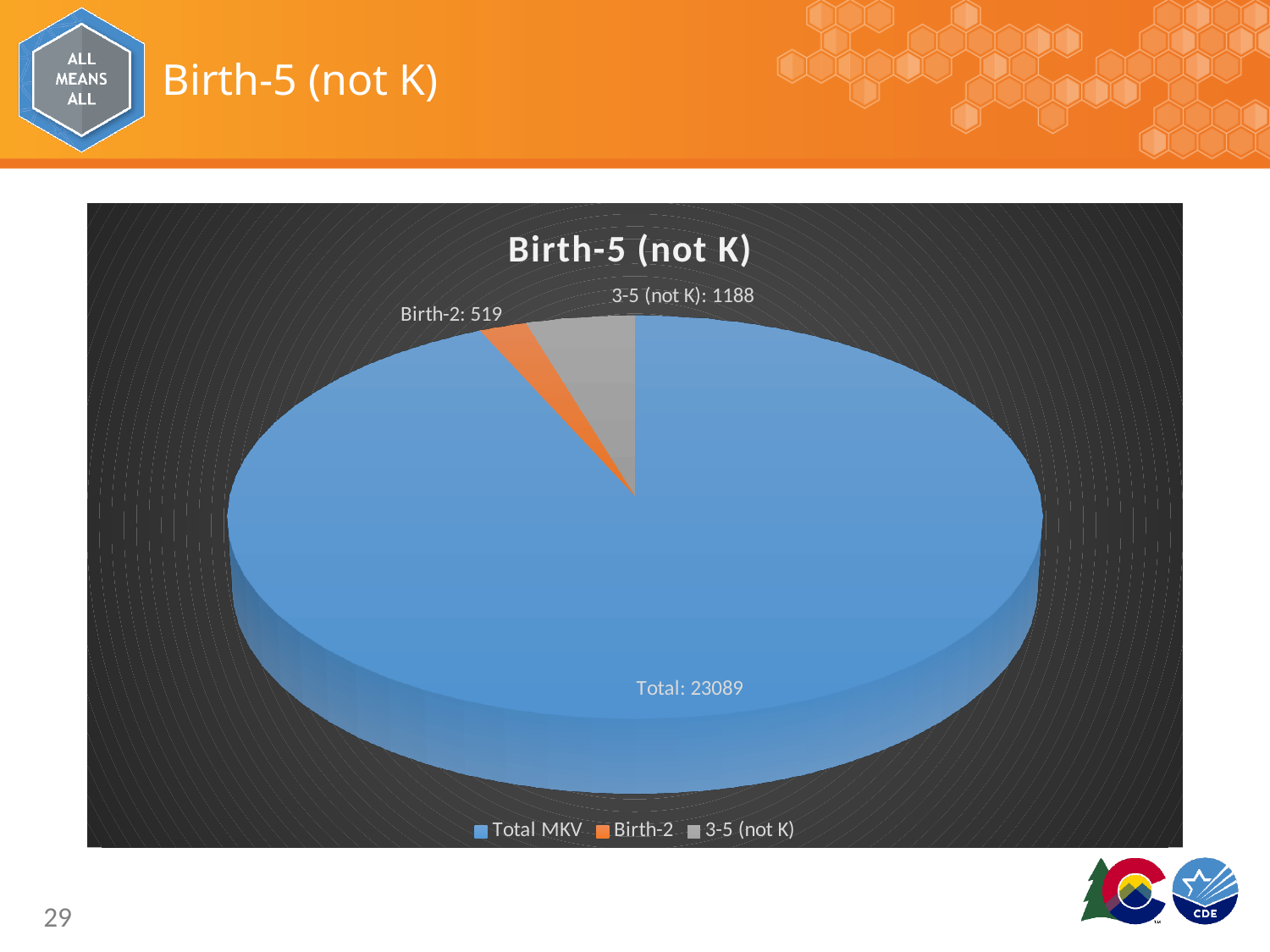
Which colour represents Birth-2 in the legend? Orange How many entries does the legend list? 3 What kind of chart is shown on the slide? Pie chart How many slices does the pie chart have? 3 What is the value for 3-5 (not K)? 1188 What is the difference between the 3-5 (not K) value and the Birth-2 value? 669 Which is larger, Birth-2 or 3-5 (not K)? 3-5 (not K) What is the value labelled Total on the largest slice? 23089 What is the value for Birth-2? 519 Which slice is the largest? Total MKV What is the title of the chart? Birth-5 (not K) Which slice is the smallest? Birth-2